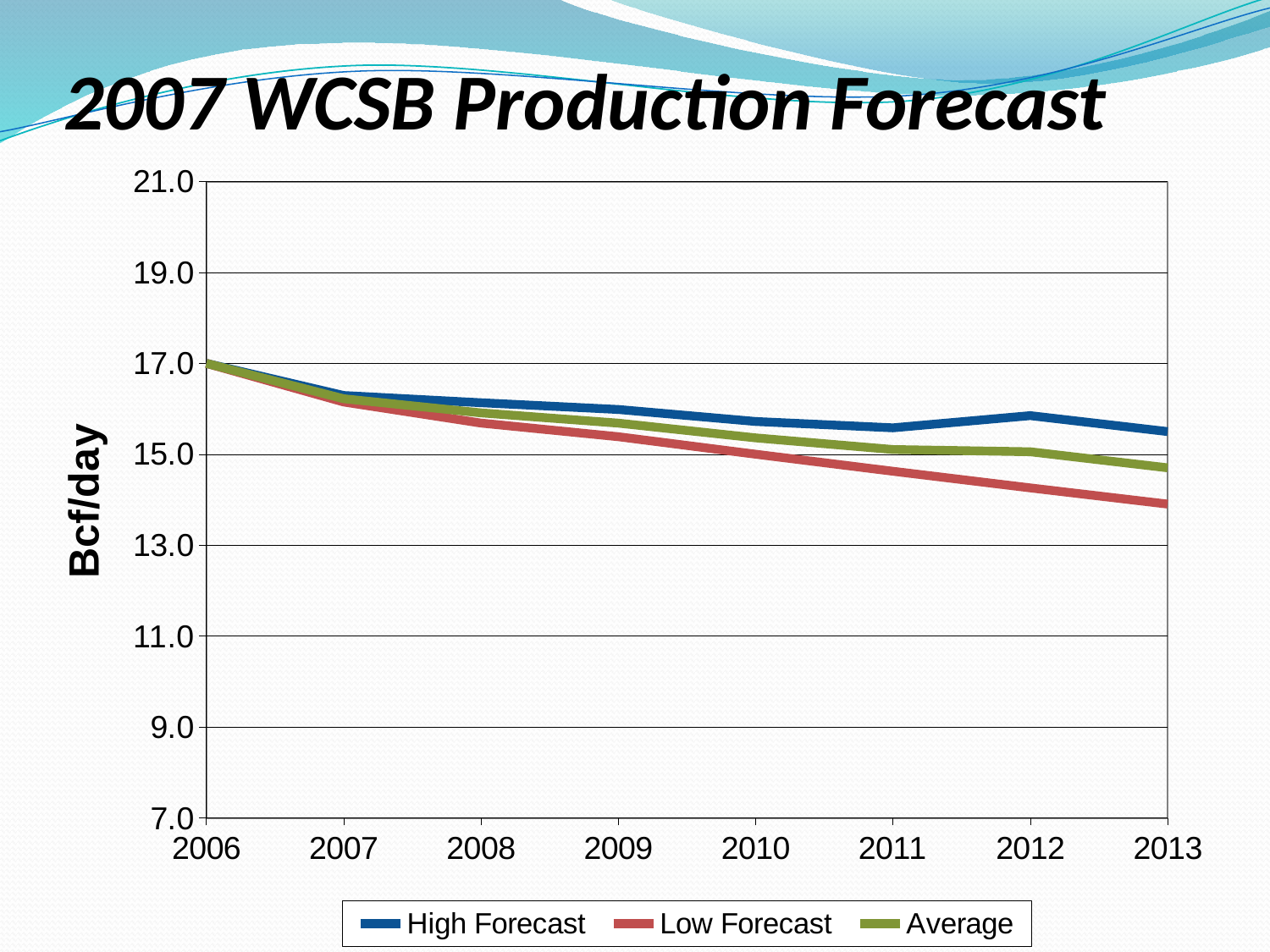
What kind of chart is shown on the slide? line chart Do the Low Forecast values rise or fall from 2006 to 2013? fall What is the label on the y axis? Bcf/day How many years are plotted along the x axis? 8 Is the Low Forecast value for 2013 greater or less than 15.0? less How many series does the legend list? 3 Which series has the highest value in 2013? High Forecast Which series has the lowest value in 2013? Low Forecast What is the title of the chart? 2007 WCSB Production Forecast Is the High Forecast value for 2013 greater or less than 15.0? greater Is the High Forecast value for 2009 greater or less than 15.0? greater